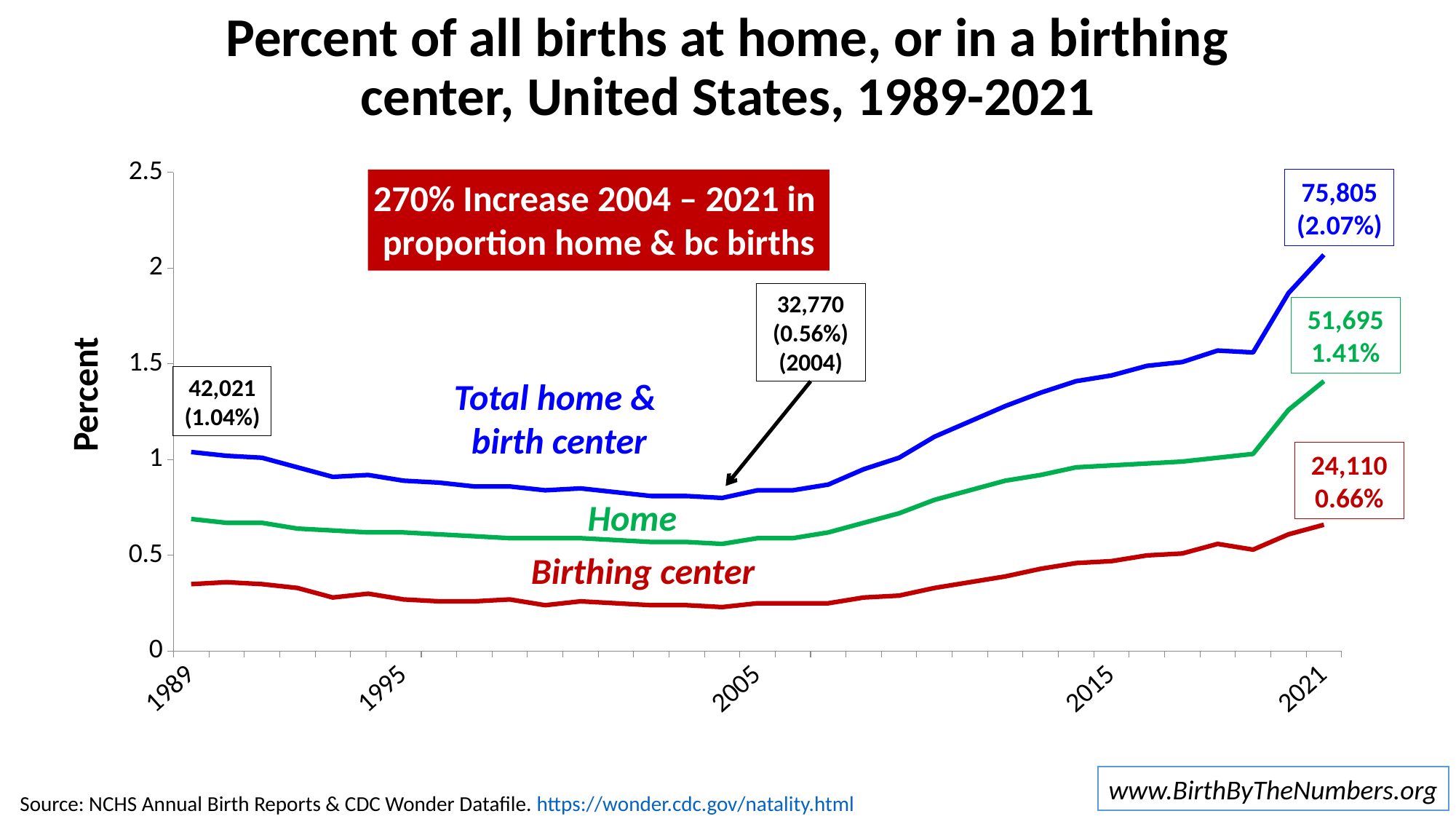
How many total home and birth center births were there in 2021? 75,805 What percent of all births were home births in 2021? 1.41% What is the title of the chart? Percent of all births at home, or in a birthing center, United States, 1989-2021 What is the difference in percentage points between the Home value (1.41%) and the Birthing center value (0.66%) in 2021? 0.75 percentage points In 2021, which is larger: the Home percent or the Birthing center percent? Home Is the Birthing center value in 2015 greater or less than 0.5? less What percent of all births were in a birthing center in 2021? 0.66% What kind of chart is shown on the slide? Line chart What was the Total home & birth center percent in 1989? 1.04% Does the Total home & birth center line rise or fall between 2004 and 2021? Rises How many data series are plotted on the chart? 3 What percent of all births were at home or in a birth center in 2021 (Total home & birth center line)? 2.07%